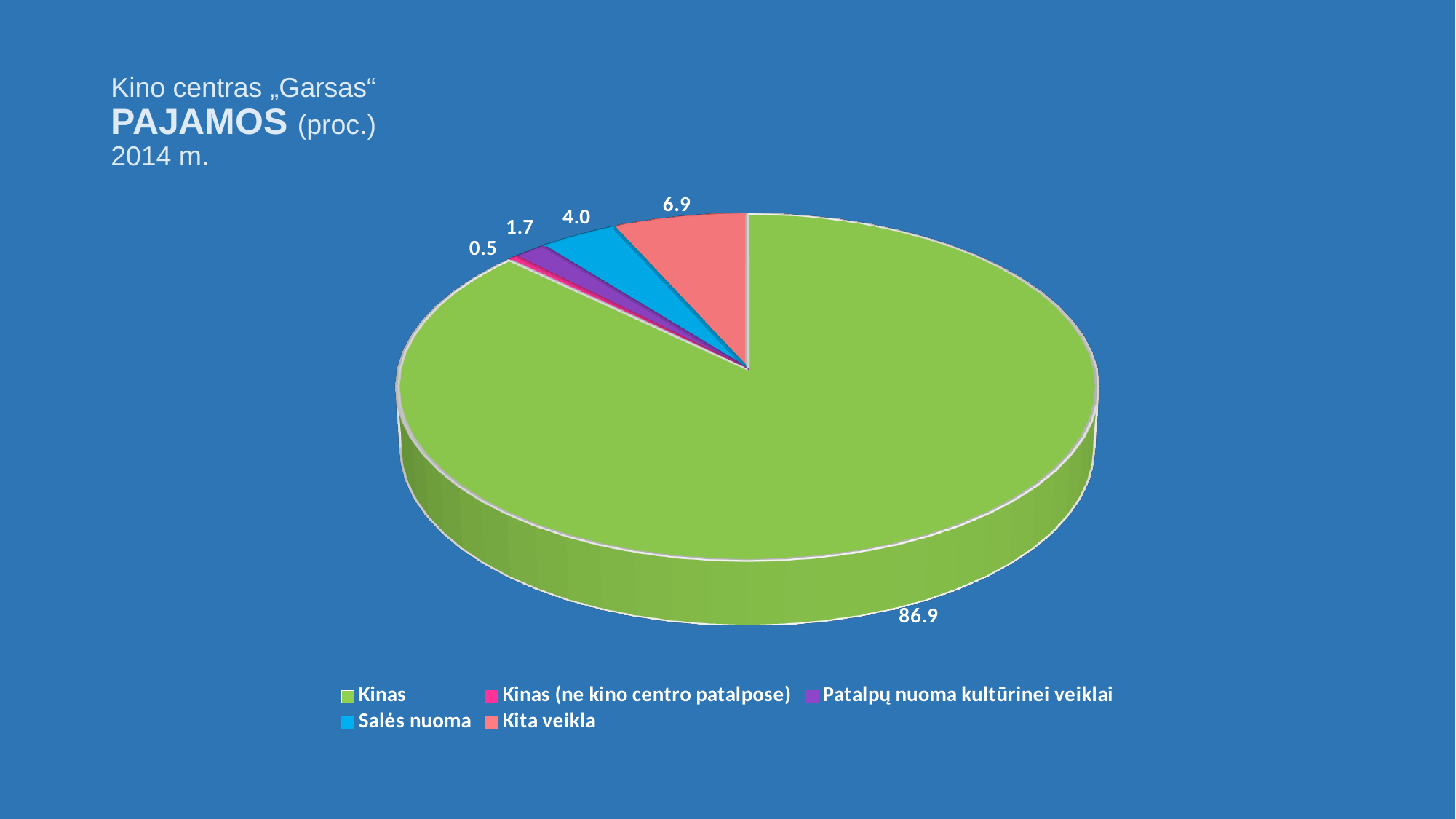
What is the value for Kinas (ne kino centro patalpose)? 0.5 What is the value for Kita veikla? 6.9 Which is larger, the value for Salės nuoma or the value for Patalpų nuoma kultūrinei veiklai? Salės nuoma What year does the chart title refer to? 2014 m. Which category has the smallest slice? Kinas (ne kino centro patalpose) What is the value for Salės nuoma? 4.0 How many categories does the legend list? 5 What kind of chart is shown on the slide? pie chart What is the value for Patalpų nuoma kultūrinei veiklai? 1.7 What is the value for Kinas? 86.9 Which category has the largest slice? Kinas What is the difference between the values for Kita veikla and Salės nuoma? 2.9